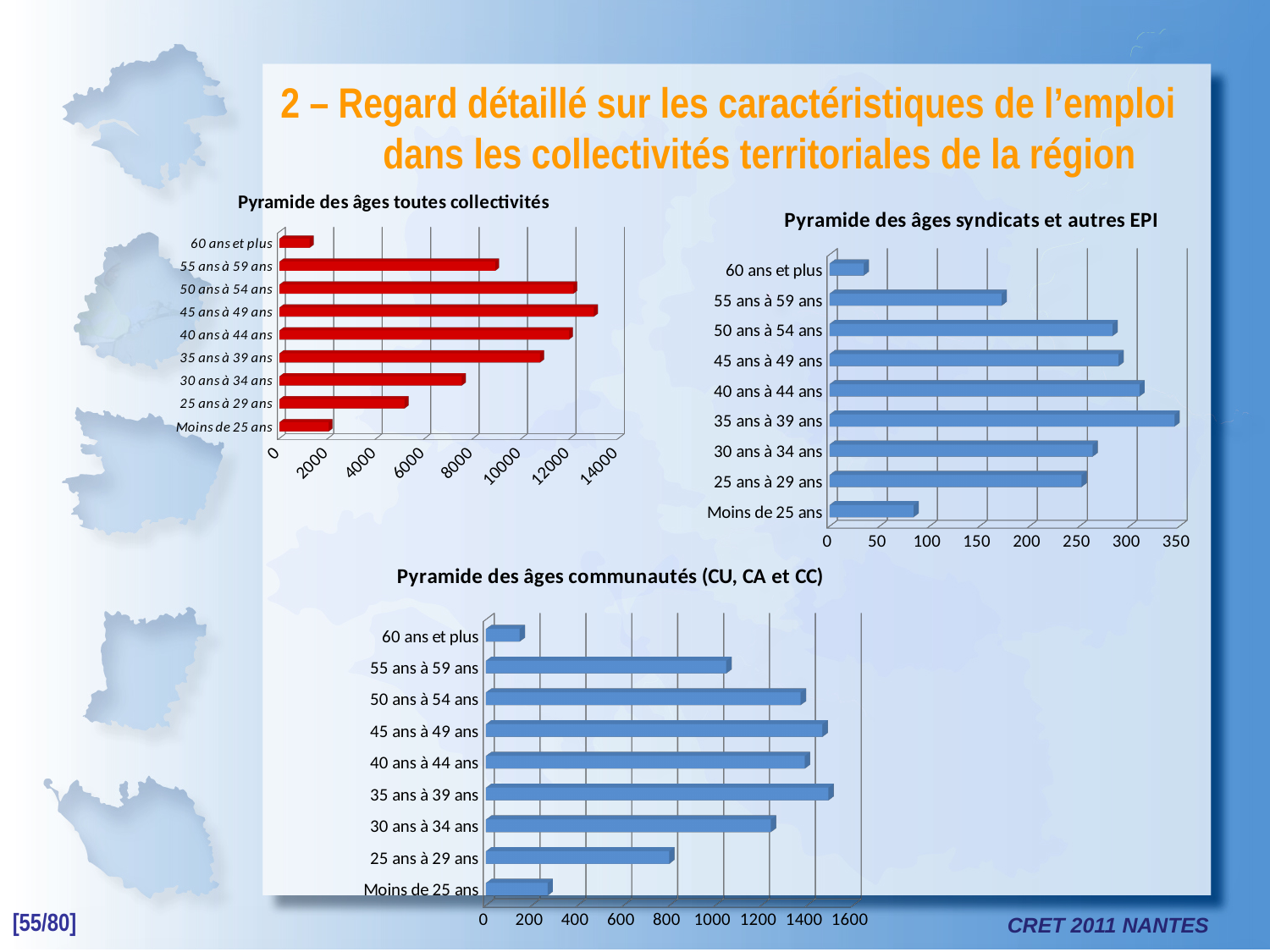
In the chart "Pyramide des âges toutes collectivités", which age category has the lowest value? 60 ans et plus How many age categories does the chart "Pyramide des âges syndicats et autres EPI" show? 9 What kind of chart is "Pyramide des âges toutes collectivités"? bar chart In the chart "Pyramide des âges syndicats et autres EPI", which age category has the highest value? 35 ans à 39 ans In the chart "Pyramide des âges syndicats et autres EPI", is the value for 55 ans à 59 ans greater or less than 150? greater In the chart "Pyramide des âges syndicats et autres EPI", which age category has the lowest value? 60 ans et plus In the chart "Pyramide des âges toutes collectivités", is the value for 25 ans à 29 ans greater or less than 4000? greater In the chart "Pyramide des âges toutes collectivités", which age category has the highest value? 45 ans à 49 ans In the chart "Pyramide des âges syndicats et autres EPI", which is larger: the value for 40 ans à 44 ans or for 30 ans à 34 ans? 40 ans à 44 ans In the chart "Pyramide des âges communautés (CU, CA et CC)", which age category has the lowest value? 60 ans et plus What colour are the bars in the chart "Pyramide des âges toutes collectivités"? red How many charts are shown on the slide? 3